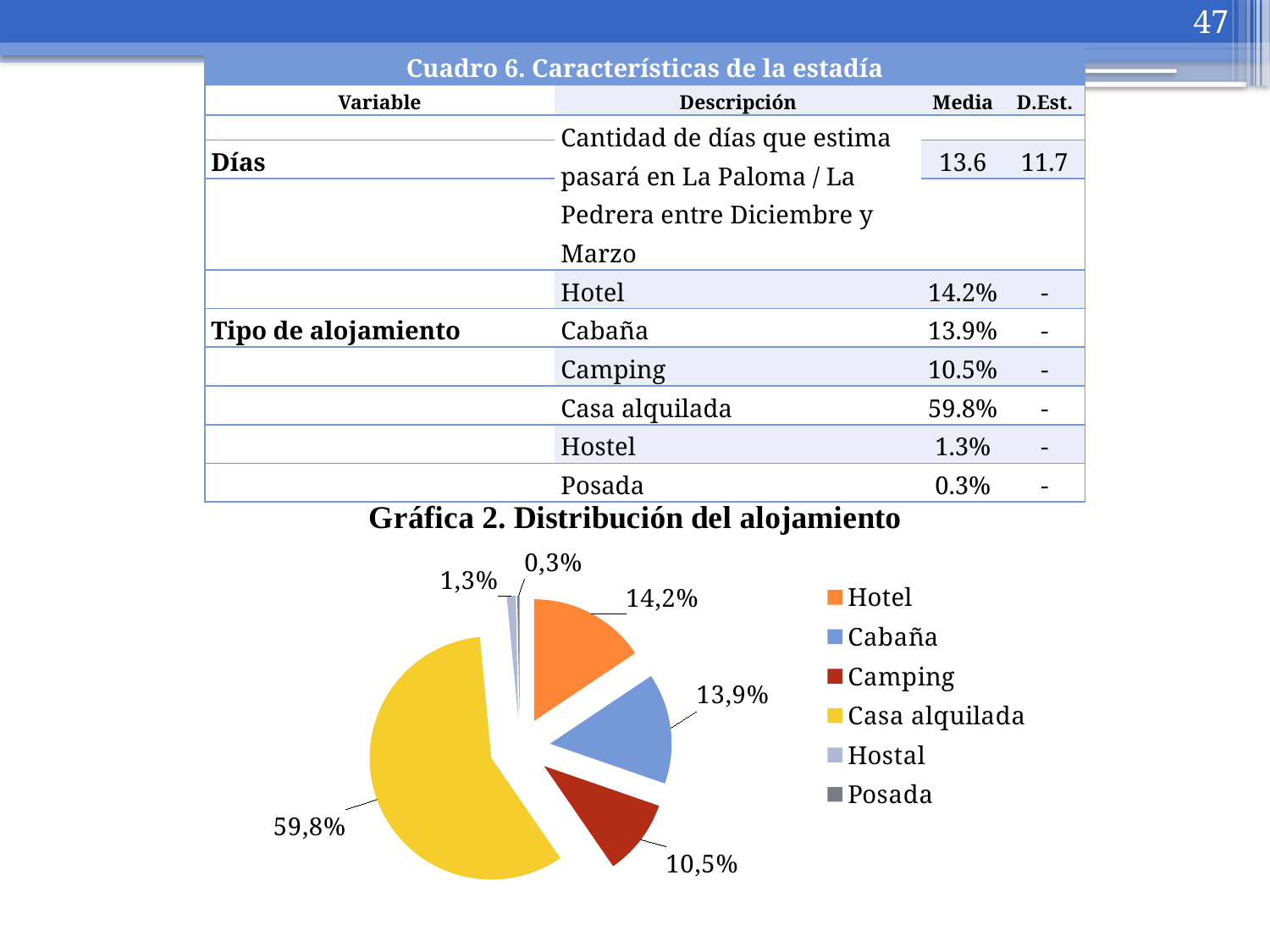
In the pie chart, what is the difference between the Casa alquilada and Hotel percentages? 45,6% What share of the pie does the Hotel slice represent? 14,2% In the pie chart, which is larger: the slice for Casa alquilada or the slice for Camping? Casa alquilada In the pie chart, what percentage is shown for Hostal? 1,3% In the pie chart, what percentage is shown for Casa alquilada? 59,8% In the pie chart, what is the difference between the Hotel and Camping percentages? 3,7% What colour is the Casa alquilada slice in the pie chart? yellow In the pie chart, what percentage is shown for Camping? 10,5% How many categories does the legend of the pie chart list? 6 What type of chart is shown under the title 'Gráfica 2. Distribución del alojamiento'? pie chart Which category has the largest slice in the pie chart? Casa alquilada Which category has the smallest slice in the pie chart? Posada